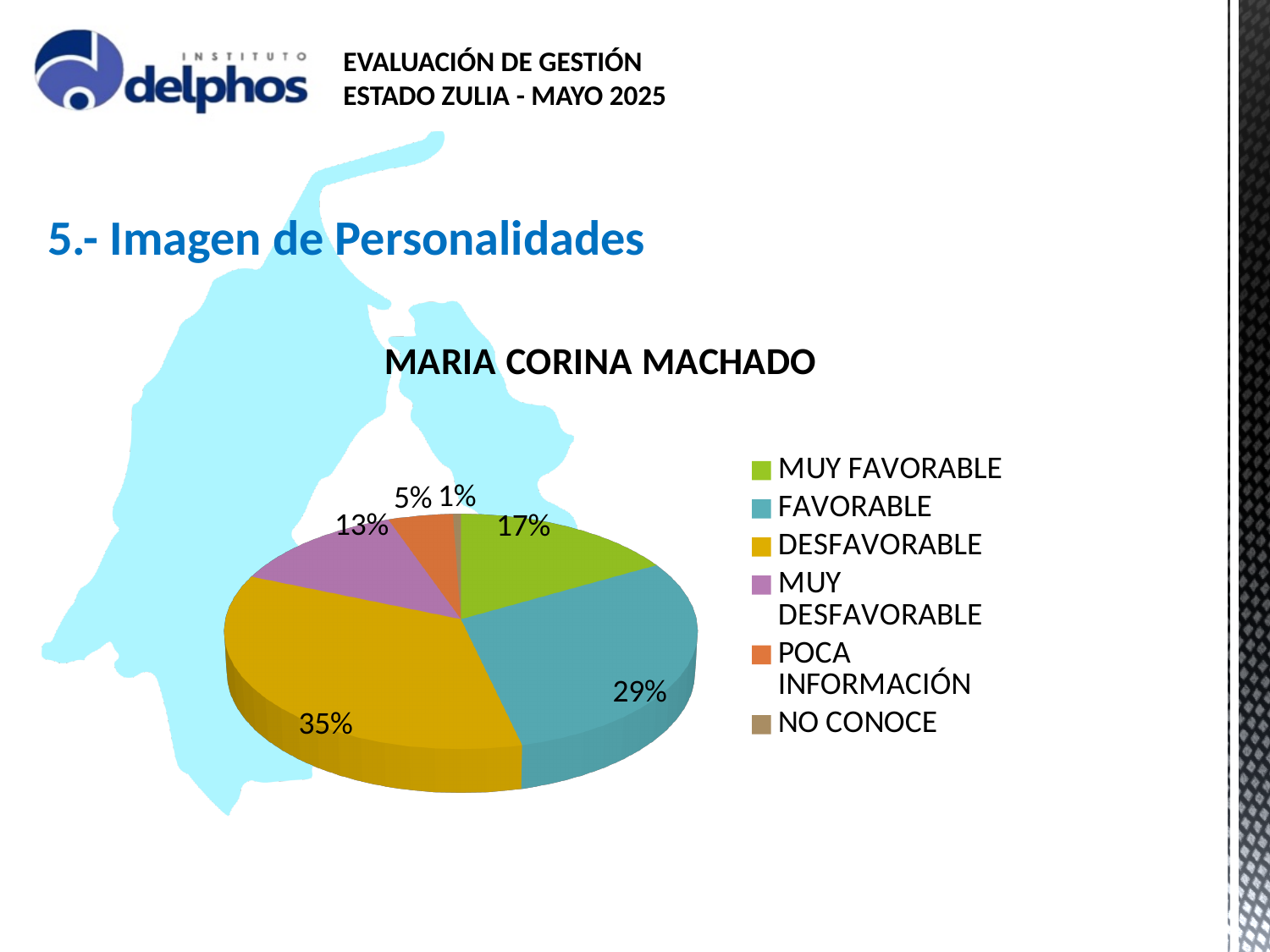
What percentage of the pie is MUY DESFAVORABLE? 13% Which is larger, the share for MUY FAVORABLE or the share for MUY DESFAVORABLE? MUY FAVORABLE Which category has the largest share of the pie? DESFAVORABLE What percentage of the pie is POCA INFORMACIÓN? 5% What kind of chart is shown on the slide? pie chart What percentage of the pie is DESFAVORABLE? 35% Which category has the smallest share of the pie? NO CONOCE What percentage of the pie is FAVORABLE? 29% What percentage of the pie is MUY FAVORABLE? 17% What is the difference in percentage points between DESFAVORABLE and FAVORABLE? 6 What is the title of the pie chart? MARIA CORINA MACHADO How many categories does the legend of the pie chart list? 6